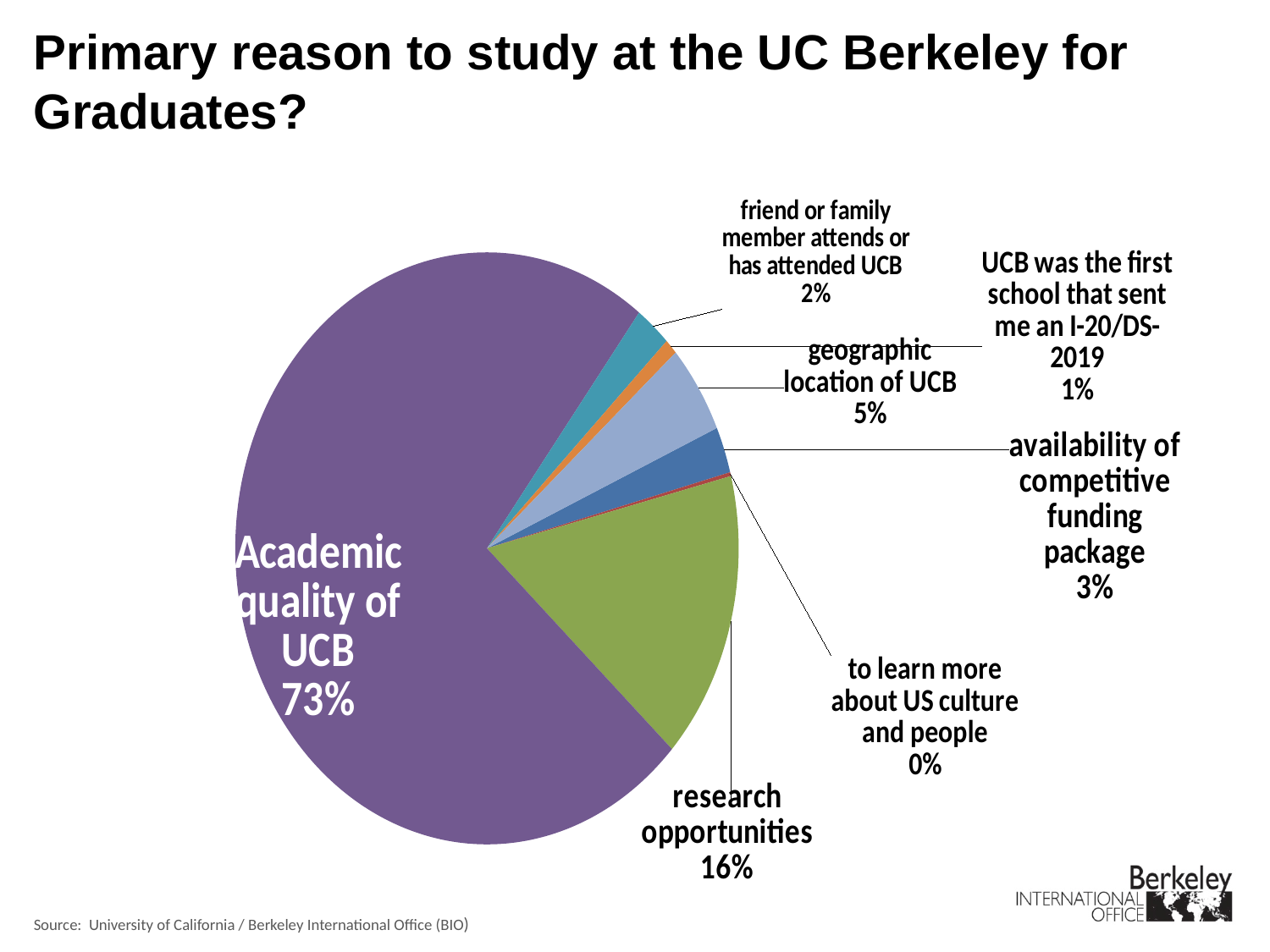
What percentage is shown for "friend or family member attends or has attended UCB"? 2% What kind of chart is shown on the slide? pie chart What share of graduates gave "Academic quality of UCB" as their primary reason? 73% What percentage is shown for "research opportunities"? 16% What percentage is shown for "UCB was the first school that sent me an I-20/DS-2019"? 1% Which is larger: the share for "geographic location of UCB" or for "availability of competitive funding package"? geographic location of UCB Which reason has the smallest share of the pie? to learn more about US culture and people What percentage is shown for "availability of competitive funding package"? 3% Which reason has the largest share of the pie? Academic quality of UCB How many slices does the pie chart have? 7 How many percentage points larger is "Academic quality of UCB" than "research opportunities"? 57 What percentage is shown for "geographic location of UCB"? 5%